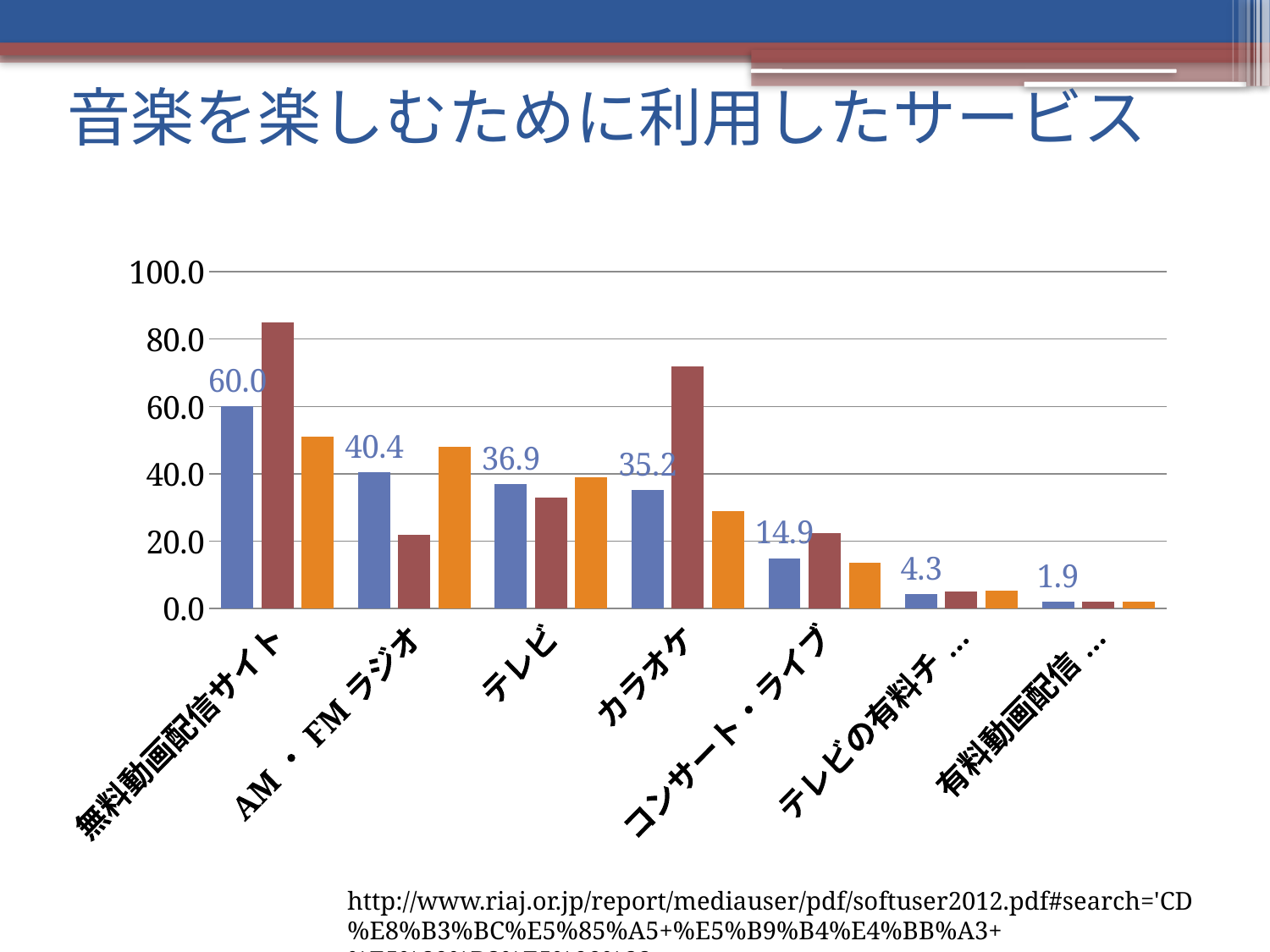
Is the value of the red bar for 無料動画配信サイト greater or less than 80.0? greater What is the title of the chart on the slide? 音楽を楽しむために利用したサービス What is the labelled value of the blue bar for 無料動画配信サイト? 60.0 Which category has the highest labelled value in the blue series? 無料動画配信サイト What is the labelled value of the blue bar for コンサート・ライブ? 14.9 Do the labelled blue-series values rise or fall from left to right along the x axis? fall What is the labelled value of the blue bar for AM・FMラジオ? 40.4 How many categories are shown on the x axis of the chart? 7 Which category has the lowest labelled value in the blue series? 有料動画配信… What is the difference between the blue-series values for 無料動画配信サイト (60.0) and AM・FMラジオ (40.4)? 19.6 What kind of chart is shown on the slide? bar chart What is the labelled value of the blue bar for カラオケ? 35.2